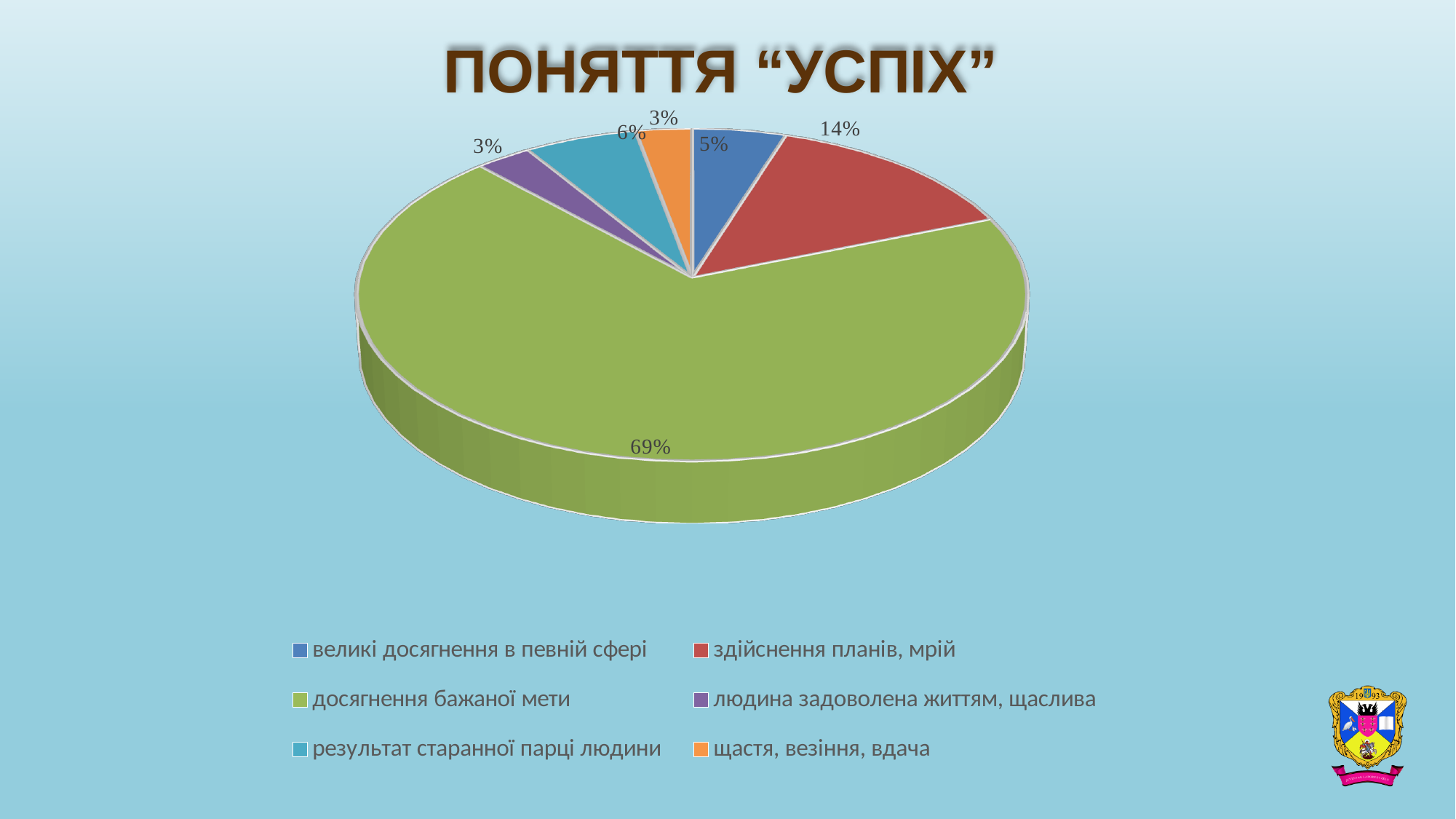
What is the title of the chart? ПОНЯТТЯ "УСПІХ" What is the value for "щастя, везіння, вдача"? 3% What is the value for "великі досягнення в певній сфері"? 5% What colour is the slice for "здійснення планів, мрій"? red Which category has the largest share of the pie? досягнення бажаної мети What share of the pie is "досягнення бажаної мети"? 69% What kind of chart is shown on the slide? pie chart What is the value for "результат старанної парці людини"? 6% Which is larger: the share for "результат старанної парці людини" or the share for "людина задоволена життям, щаслива"? результат старанної парці людини What is the value for "здійснення планів, мрій"? 14% What is the difference between the shares for "здійснення планів, мрій" and "великі досягнення в певній сфері"? 9% How many slices does the pie chart have? 6